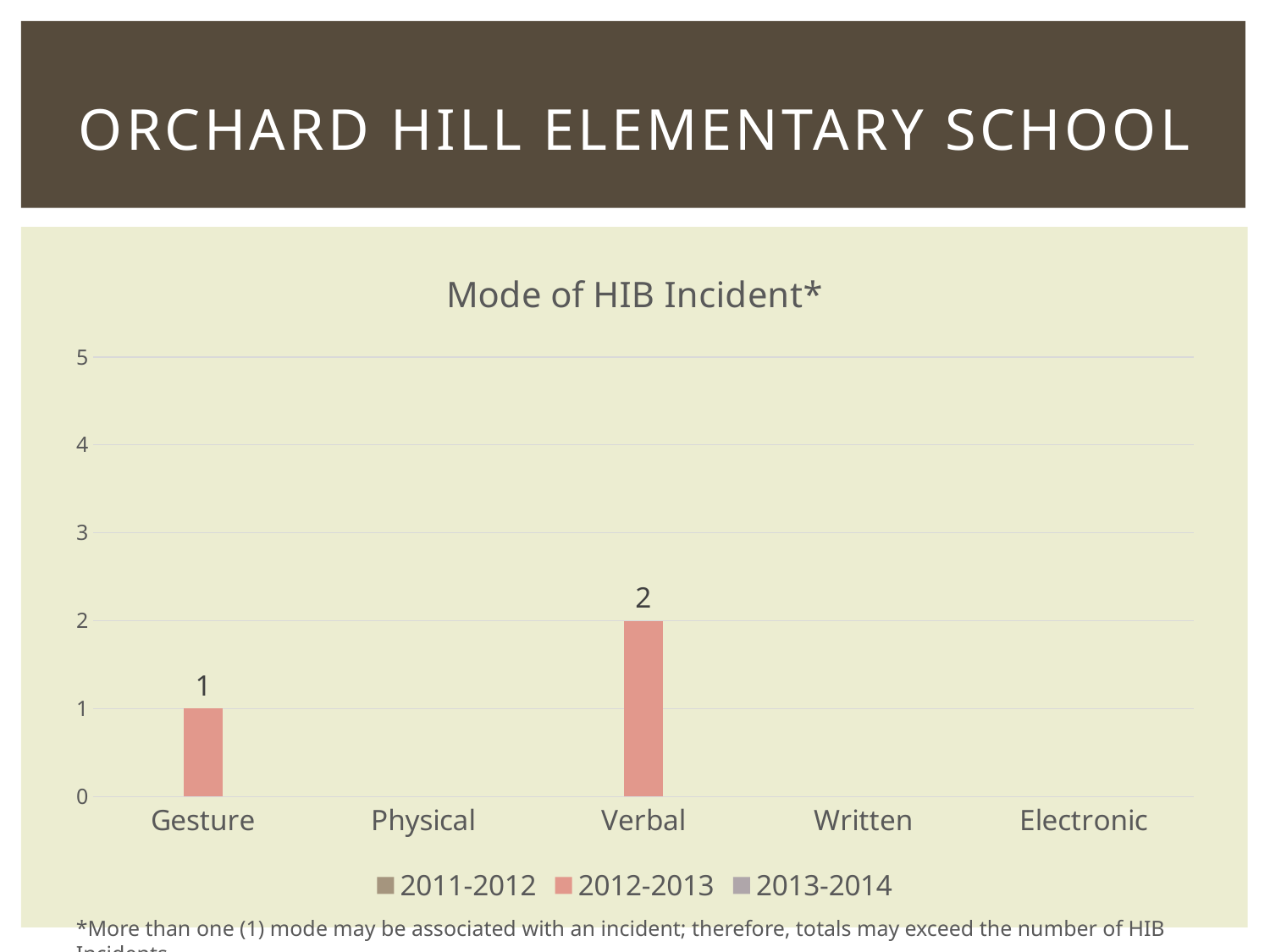
Which series in the legend is the only one with visible bars on the chart? 2012-2013 What is the value for Verbal in the 2012-2013 series? 2 Is the 2012-2013 value for Gesture greater or less than 2? less What is the title of the chart? Mode of HIB Incident* Which is larger in the 2012-2013 series, Verbal or Gesture? Verbal What kind of chart is shown on the slide? bar chart Which category has the highest value in the 2012-2013 series? Verbal How many series does the legend list? 3 What is the value for Gesture in the 2012-2013 series? 1 How many categories are shown on the x axis? 5 Is the 2012-2013 value for Verbal greater or less than 3? less What is the difference between the 2012-2013 values for Verbal and Gesture? 1